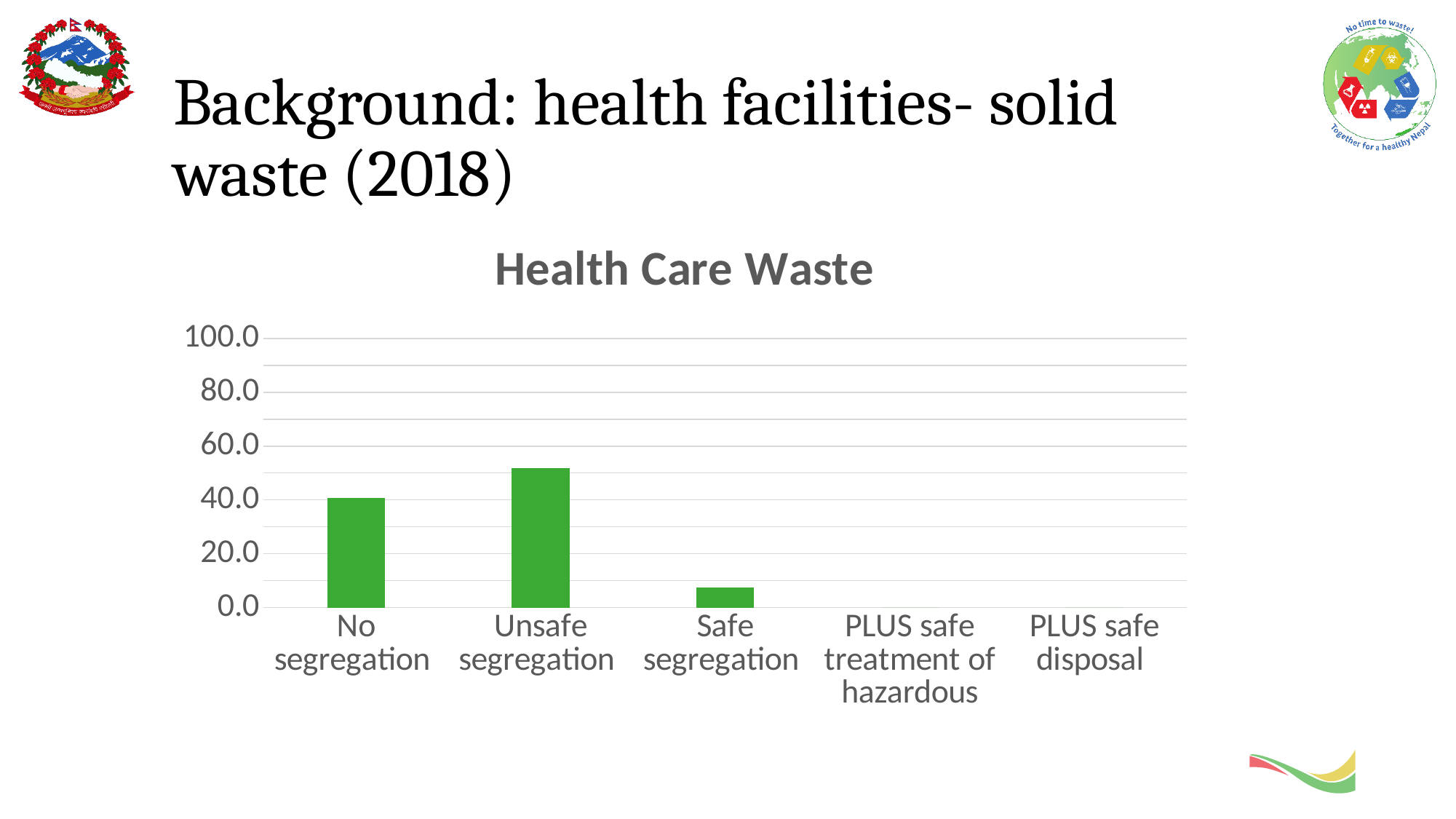
Is the value for No segregation greater or less than 20? greater What is the title of the chart? Health Care Waste Is the value for Unsafe segregation greater or less than 40? greater Is the value for Safe segregation greater or less than 20? less How many categories are shown on the x axis of the chart? 5 Which is larger, the value for No segregation or the value for Unsafe segregation? Unsafe segregation What kind of chart is shown on the slide? bar chart Which category has the highest value in the chart? Unsafe segregation What colour are the bars in the chart? green Which is larger, the value for Safe segregation or the value for No segregation? No segregation